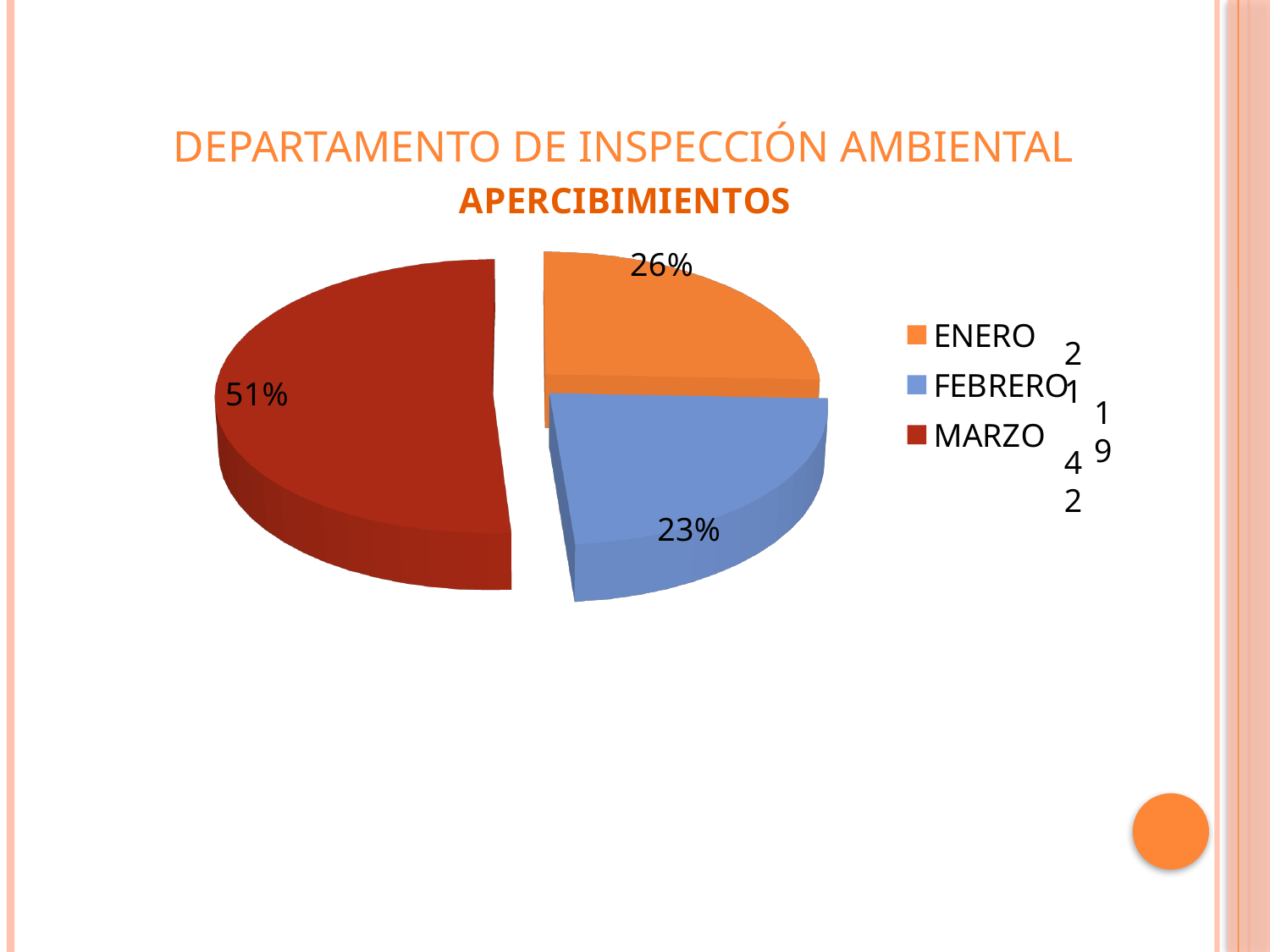
Which month has the smallest share of the pie? FEBRERO How many slices does the pie chart have? 3 What is the difference in percentage points between the MARZO share and the ENERO share? 25 What is the difference in percentage points between the ENERO share and the FEBRERO share? 3 Which month has the largest share of the pie? MARZO What percentage of the pie does FEBRERO represent? 23% Which is larger, the share for ENERO or the share for FEBRERO? ENERO What colour is the MARZO slice? dark red What percentage of the pie does MARZO represent? 51% How many entries does the legend list? 3 What kind of chart is shown on the slide? pie chart What percentage of the pie does ENERO represent? 26%